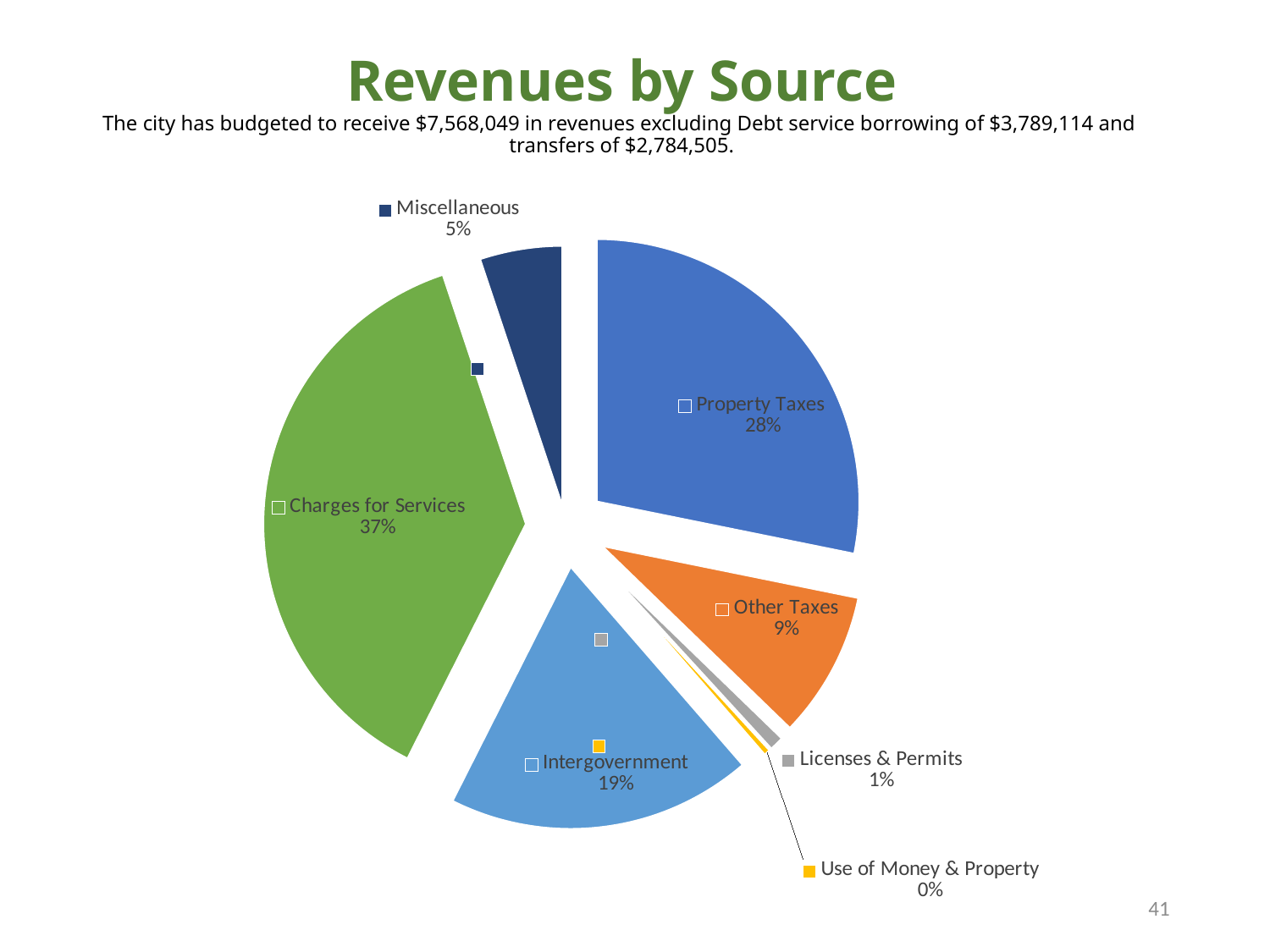
What share of revenues comes from Licenses & Permits? 1% How many percentage points larger is the Charges for Services share than the Property Taxes share? 9 What type of chart is shown on the slide? Pie chart How many revenue sources are shown in the pie chart? 7 What is the title of the chart? Revenues by Source What share of revenues comes from Charges for Services? 37% What share of revenues comes from Intergovernment? 19% What share of revenues comes from Other Taxes? 9% Which revenue source has the smallest share of the pie? Use of Money & Property What share of revenues comes from Property Taxes? 28% Which is larger, the share for Intergovernment or the share for Other Taxes? Intergovernment Which revenue source has the largest share of the pie? Charges for Services